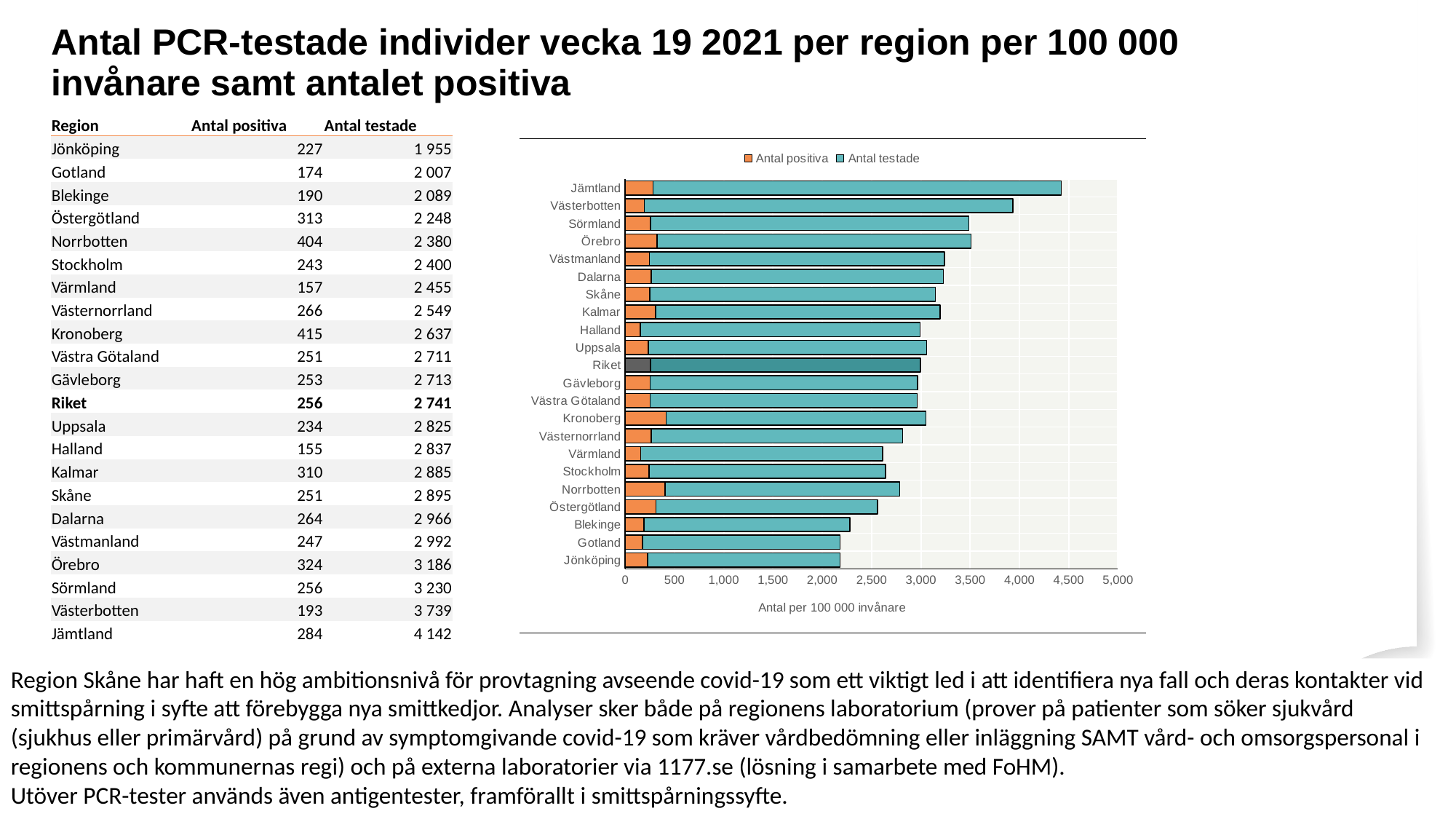
How many bars (regions including Riket) are shown in the chart? 22 What kind of chart is shown on the slide? bar chart What is the value of Antal positiva for Kronoberg? 415 What is the difference in Antal testade between Jämtland and Västerbotten? 403 What is the value of Antal testade for Riket? 2 741 Which region has the lowest Antal testade? Jönköping What is the x-axis title of the chart? Antal per 100 000 invånare What is the value of Antal testade for Jämtland? 4 142 How many series does the chart legend list? 2 Which has the larger Antal testade, Örebro or Sörmland? Sörmland Which region has the highest Antal positiva? Kronoberg Which region has the highest Antal testade? Jämtland